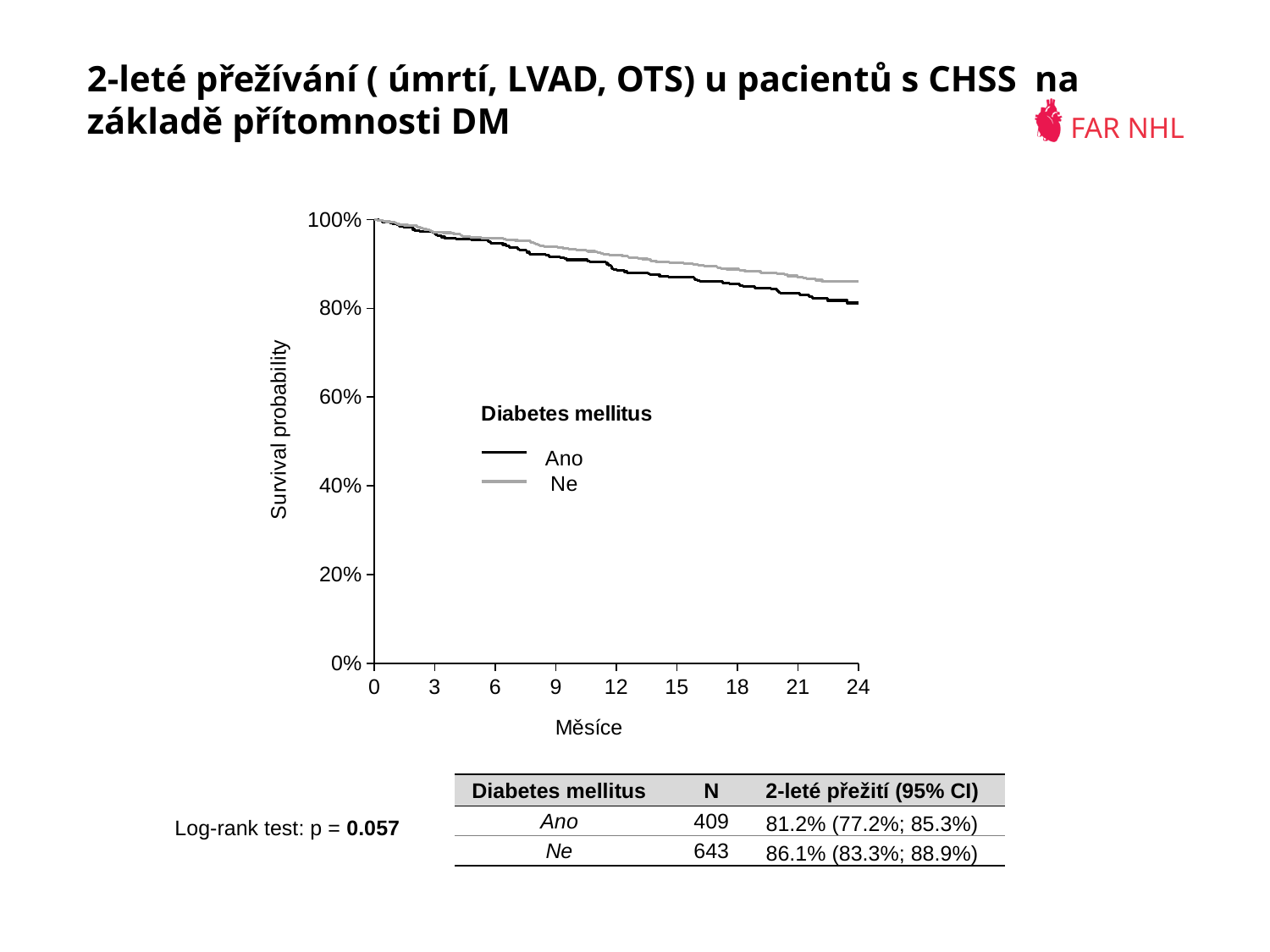
How many series does the legend list? 2 What kind of chart is shown on the slide? line chart Is the survival probability for the Ne group at 24 months greater or less than 80%? greater What is the difference in 2-year survival between the Ne and Ano groups? 4.9% What is the N for the Ano group? 409 What is the 2-year survival for the Ano group? 81.2% What is the p value of the log-rank test? 0.057 Do the survival curves rise or fall as the months increase along the x axis? fall What is the 2-year survival for the Ne group? 86.1% What are the two legend entries under "Diabetes mellitus"? Ano and Ne What is the label of the y axis? Survival probability Which group has the higher survival probability at 24 months, Ano or Ne? Ne